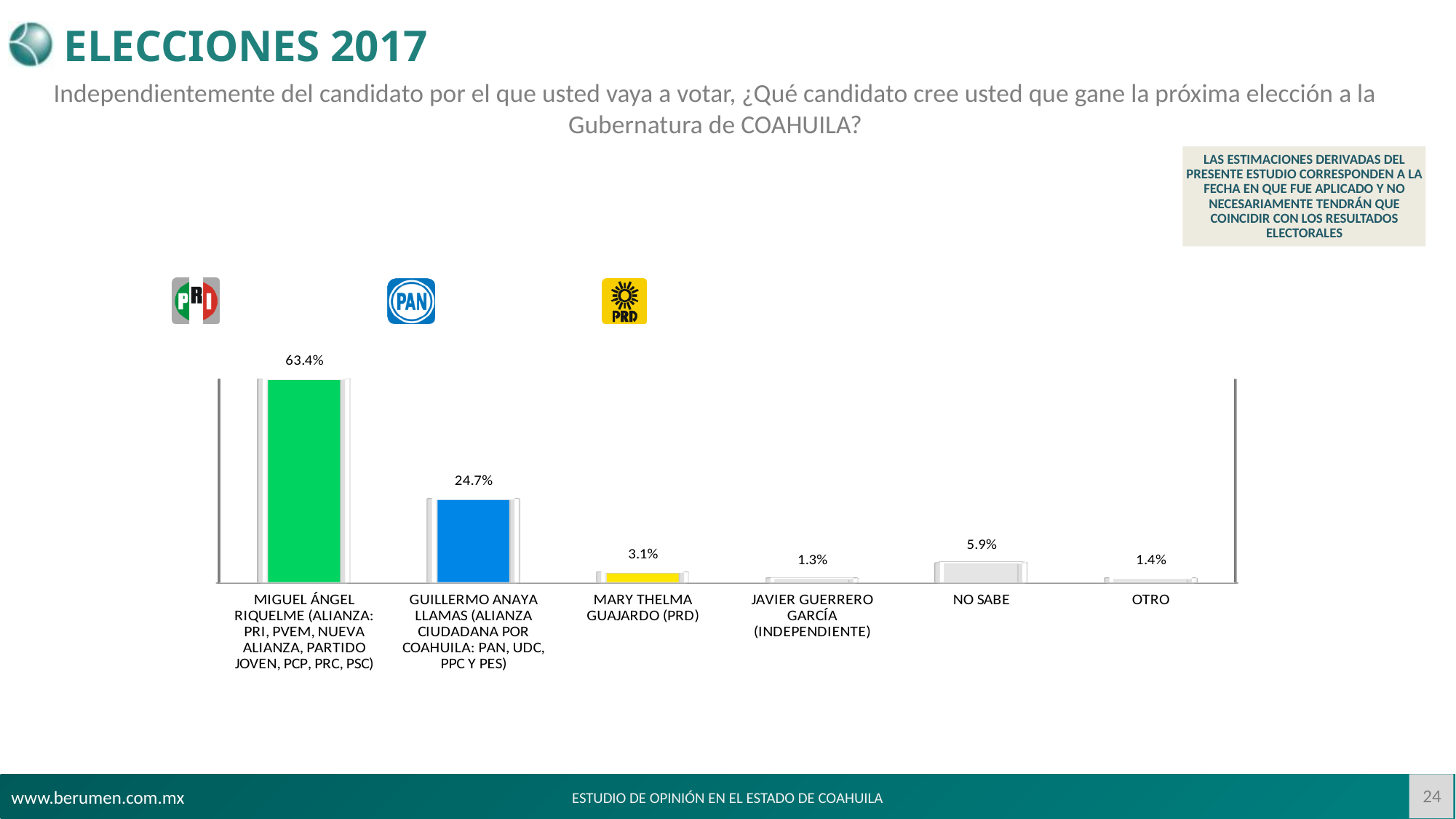
What percentage is shown for Mary Thelma Guajardo (PRD)? 3.1% What percentage of respondents believe Miguel Ángel Riquelme will win the election? 63.4% How many categories are shown on the x axis of the chart? 6 What is the value shown for Guillermo Anaya Llamas? 24.7% What is the difference between the values for 'Otro' and Javier Guerrero García? 0.1% Which candidate or category has the highest value in the chart? Miguel Ángel Riquelme Which is larger, the value for 'No sabe' or the value for Mary Thelma Guajardo? No sabe What is the difference between the values for Miguel Ángel Riquelme and Guillermo Anaya Llamas? 38.7% What colour is the bar for Guillermo Anaya Llamas? Blue What type of chart is shown on the slide? Bar chart Which category has the lowest value in the chart? Javier Guerrero García (Independiente) What is the value for the 'No sabe' category? 5.9%